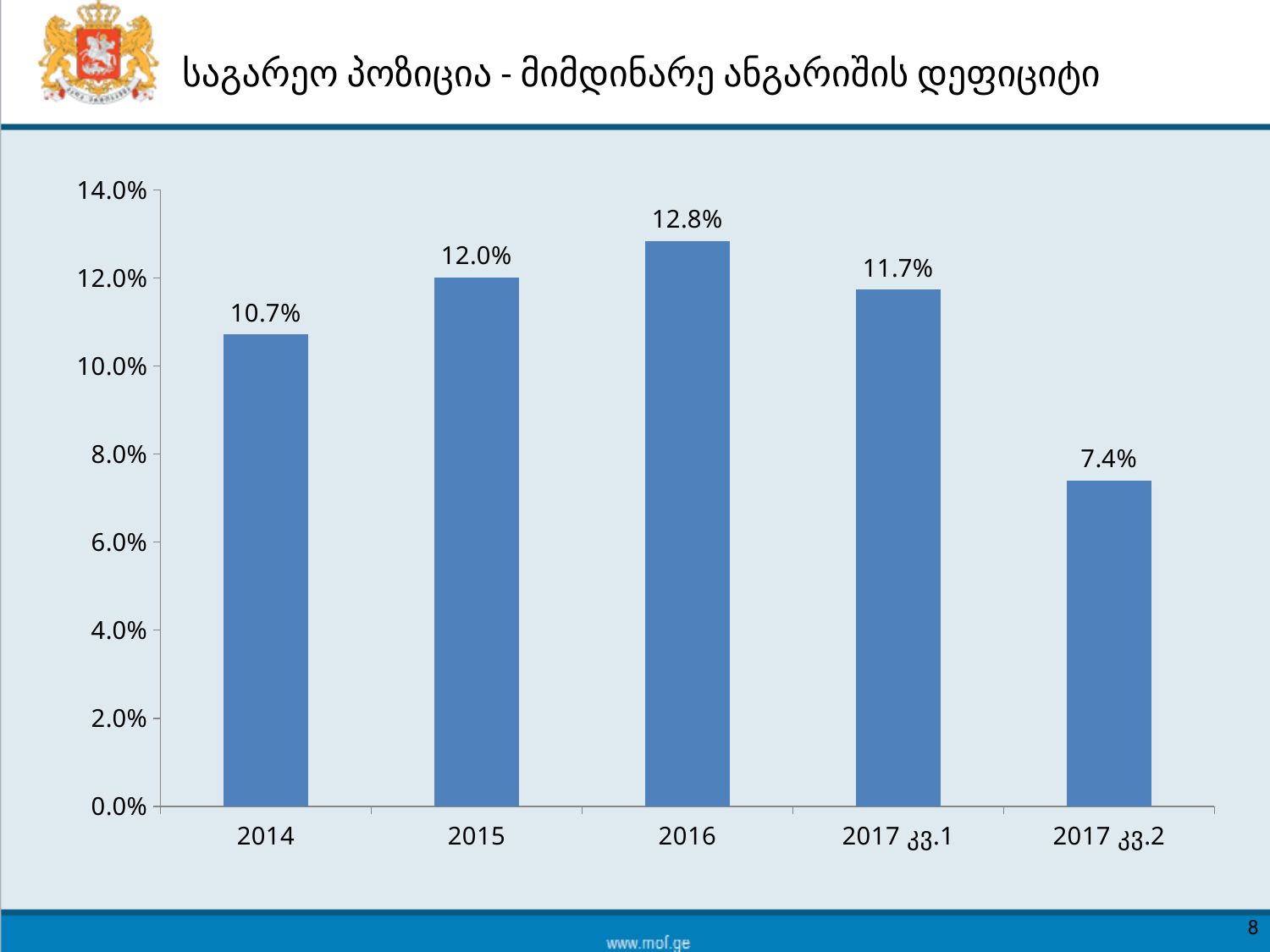
Do the values rise or fall from 2016 to 2017 კვ.2? fall What kind of chart is shown on the slide? bar chart How many categories are shown on the x axis? 5 Which category has the highest value? 2016 Is the value for 2017 კვ.2 greater or less than 8.0%? less What is the value for 2014? 10.7% Which category has the lowest value? 2017 კვ.2 What is the value for 2016? 12.8% Which is larger, the value for 2015 or the value for 2017 კვ.1? 2015 What is the difference between the values for 2016 and 2017 კვ.2? 5.4% What is the value for 2017 კვ.2? 7.4% What is the difference between the values for 2015 and 2014? 1.3%